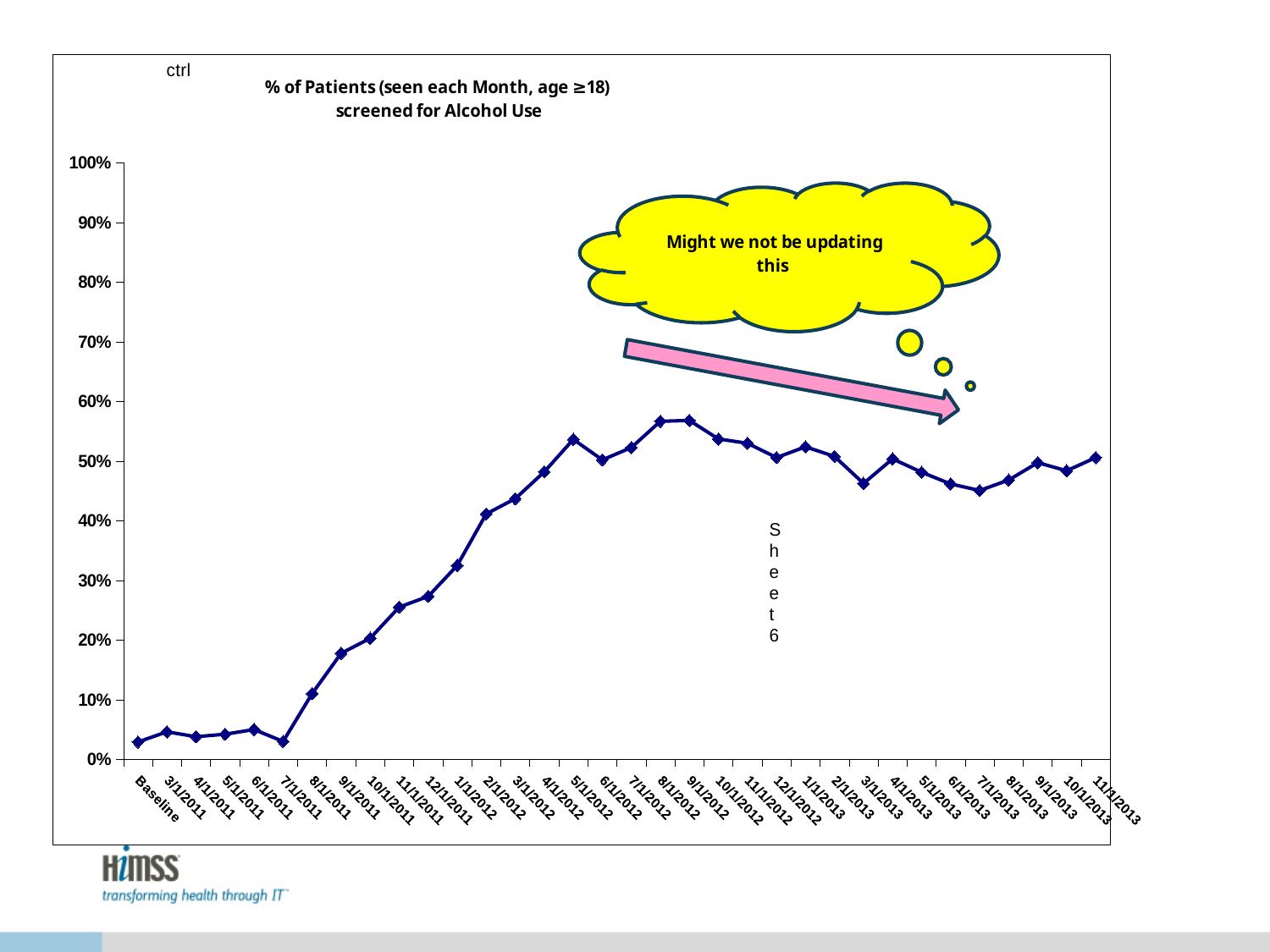
Is the value for 2/1/2012 greater or less than 40%? greater Is the value for 7/1/2011 greater or less than 10%? less Is the value for 8/1/2012 greater or less than 50%? greater What kind of chart is shown on the slide? line chart Do the values rise or fall between 7/1/2011 and 5/1/2012? rise What is the first category label on the x axis? Baseline What is the title of the chart? % of Patients (seen each Month, age ≥18) screened for Alcohol Use How many data points are plotted along the x axis? 34 Which is larger, the value for 8/1/2012 or the value for 7/1/2013? 8/1/2012